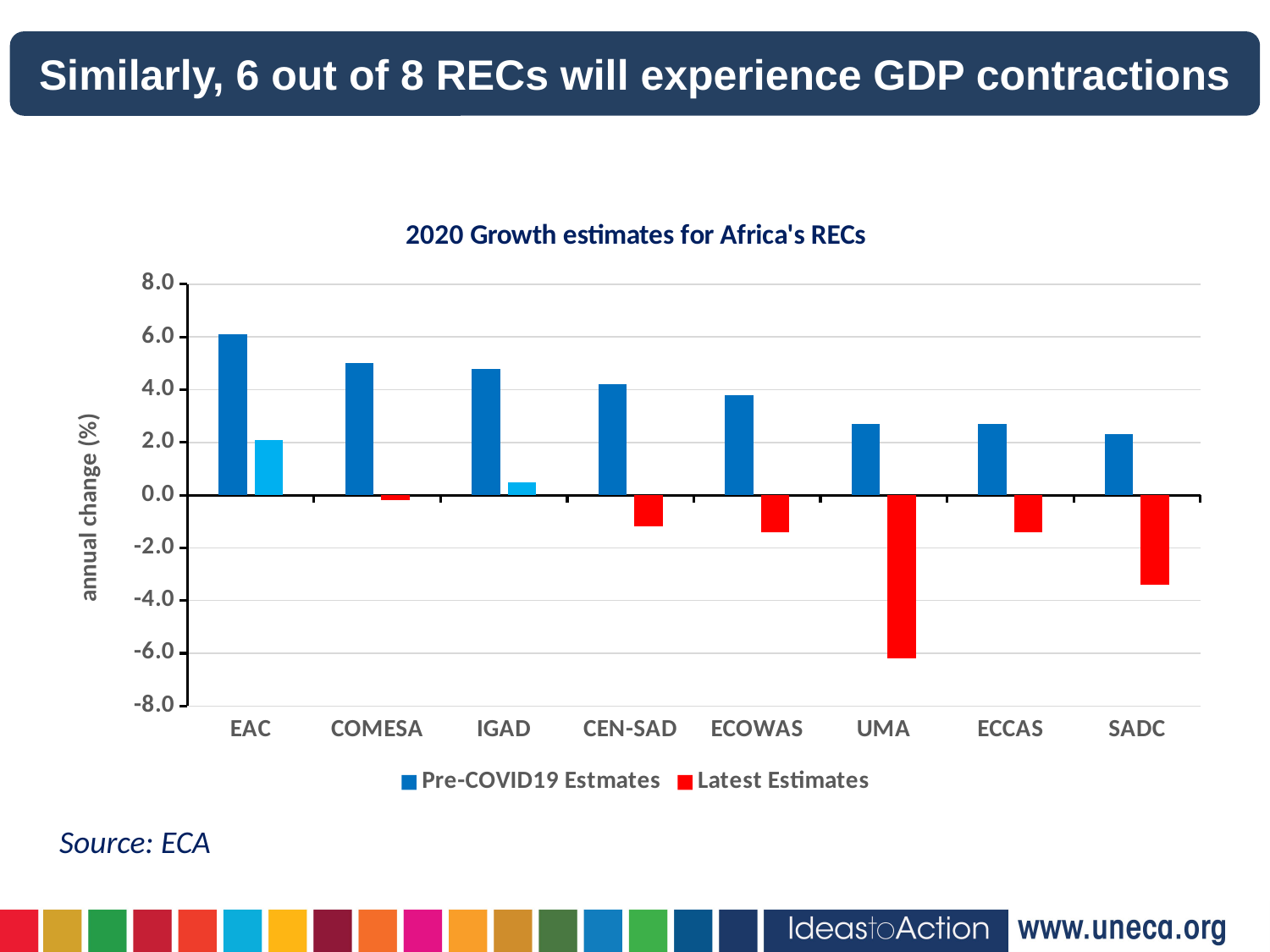
How many RECs (categories) are shown on the x axis of the chart? 8 Do the Pre-COVID19 Estimates values generally rise or fall moving from EAC to SADC along the x axis? fall Which is larger, the Latest Estimates value for EAC or the Latest Estimates value for IGAD? EAC Is the Latest Estimates value for SADC greater or less than -2.0? less What kind of chart is shown on the slide? bar chart What is the title of the chart? 2020 Growth estimates for Africa's RECs How many series does the chart's legend list? 2 Which REC has the highest Pre-COVID19 Estimates value? EAC Which REC has the lowest Latest Estimates value? UMA Is the Latest Estimates value for UMA greater or less than -6.0? less Is the Pre-COVID19 Estimates value for SADC greater or less than 2.0? greater